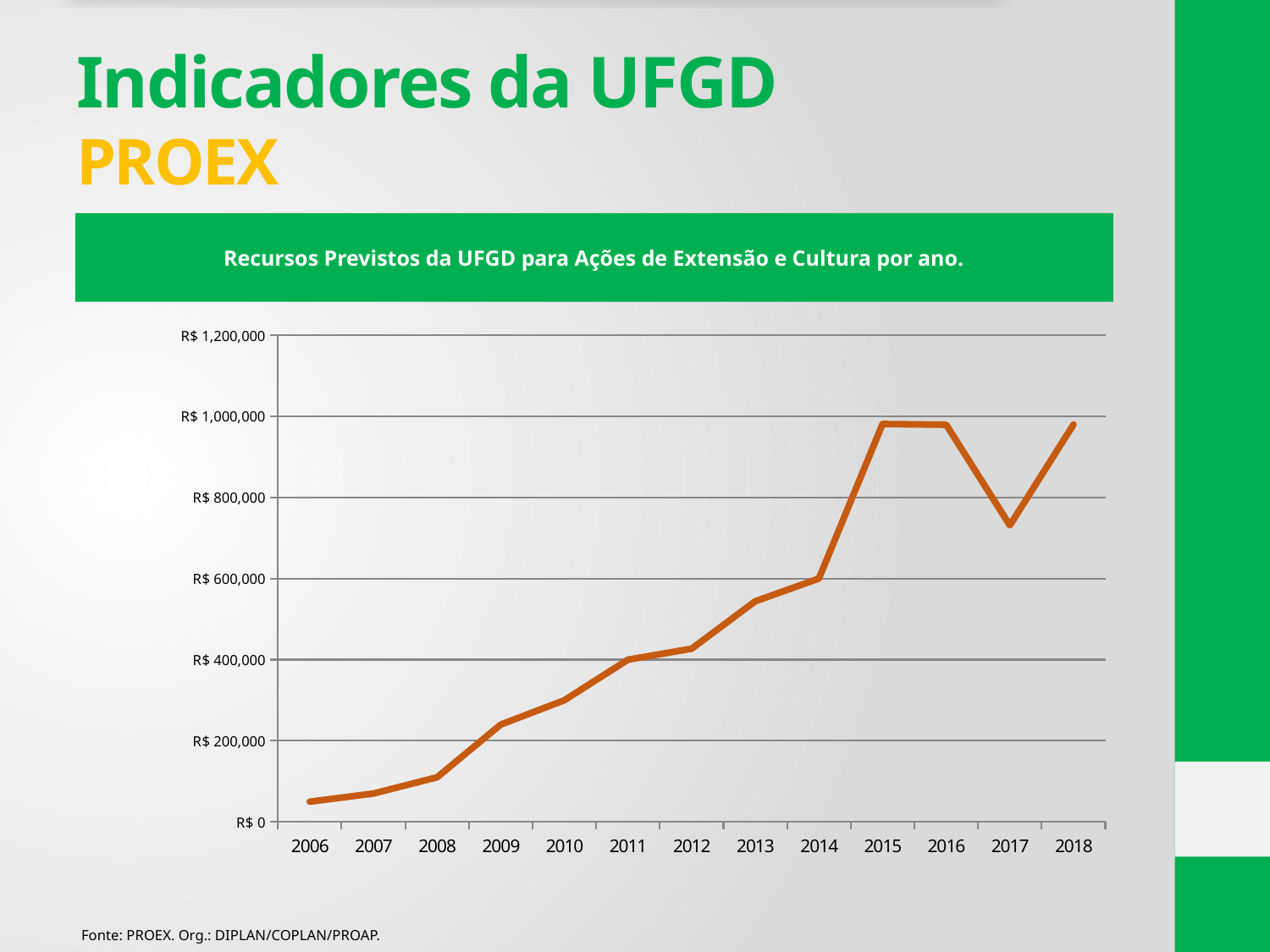
Is the value for 2010 greater or less than R$ 200,000? greater Is the value for 2017 greater or less than R$ 800,000? less How many years are plotted on the x axis of the chart? 13 Which year has the lowest value in the chart? 2006 Which year has the larger value, 2016 or 2017? 2016 Which year has the larger value, 2008 or 2009? 2009 Is the value for 2013 greater or less than R$ 600,000? less What is the title of the chart? Recursos Previstos da UFGD para Ações de Extensão e Cultura por ano. What kind of chart is shown on the slide? line chart Do the values generally rise or fall from 2006 to 2015? rise